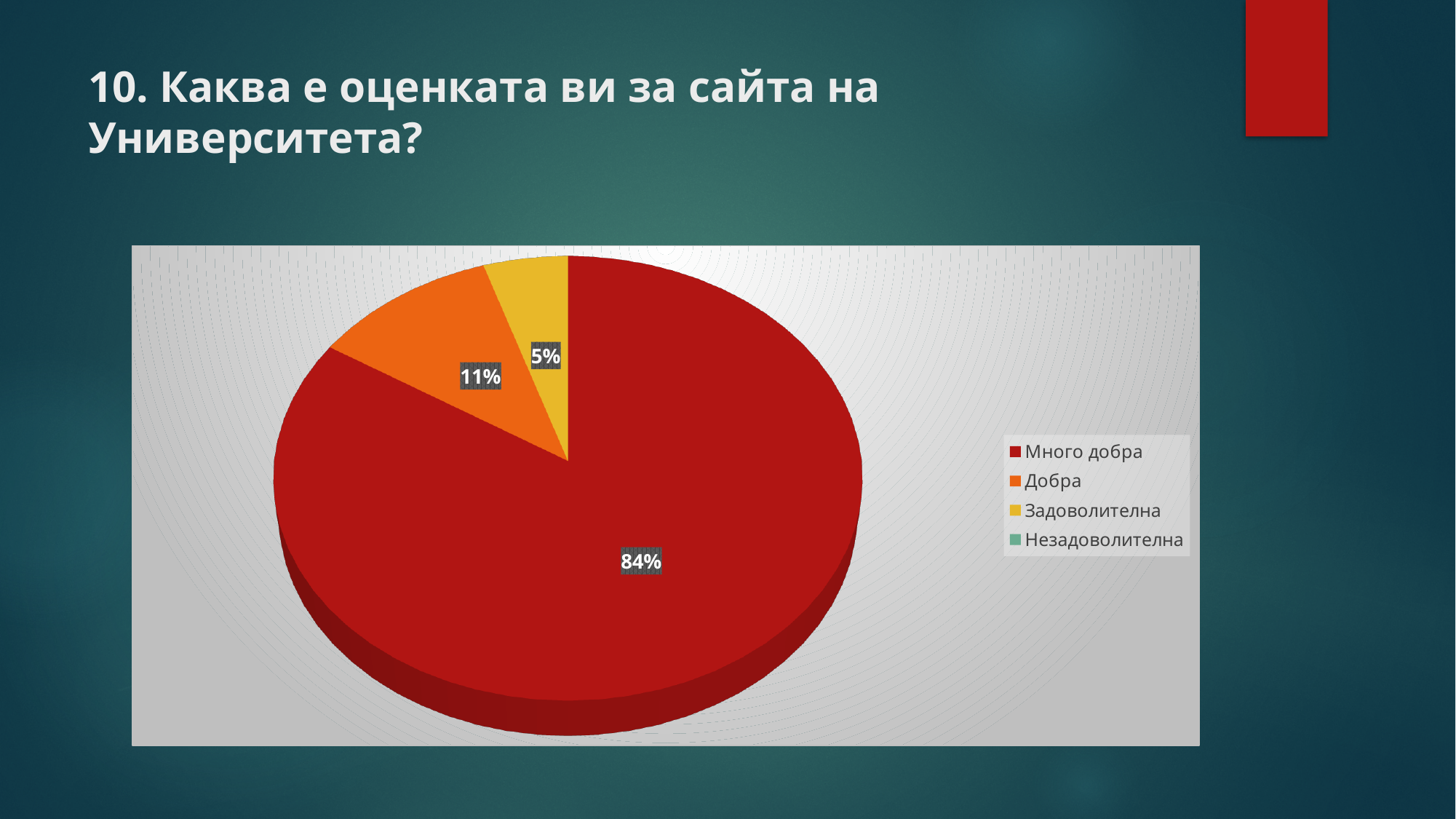
What is the difference in percentage points between "Добра" and "Задоволителна"? 6 Which category has the largest slice of the pie? Много добра What share of the pie does "Добра" have? 11% What is the title of the slide containing the chart? 10. Каква е оценката ви за сайта на Университета? What kind of chart is shown on the slide? pie chart What share of the pie does "Много добра" have? 84% What colour is the slice for "Добра"? orange What is the difference in percentage points between "Много добра" and "Добра"? 73 How many entries does the legend list? 4 What share of the pie does "Задоволителна" have? 5% Which is larger, the share for "Добра" or the share for "Задоволителна"? Добра Which of the labelled slices is the smallest? Задоволителна